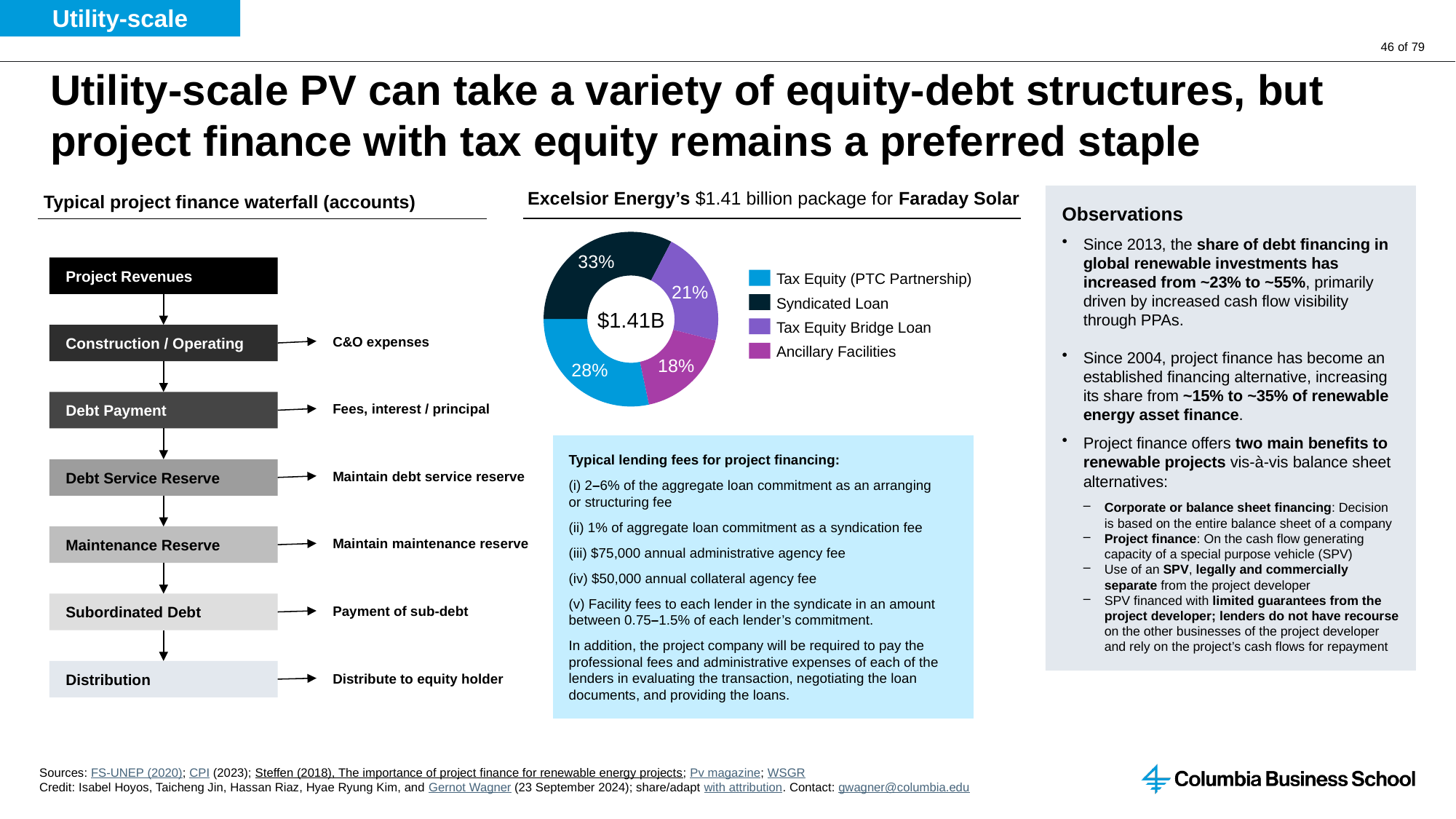
What kind of chart is used to show the Faraday Solar package? Pie chart (donut) What share of the package is Tax Equity (PTC Partnership)? 28% How many slices does the chart have? 4 Which component makes up the smallest share of the package? Ancillary Facilities Which component makes up the largest share of the package? Syndicated Loan How many entries does the chart's legend list? 4 What share of the package is Ancillary Facilities? 18% Which is larger: the Tax Equity (PTC Partnership) share or the Tax Equity Bridge Loan share? Tax Equity (PTC Partnership) What share of the package is the Tax Equity Bridge Loan? 21% What share of the package does the Syndicated Loan represent? 33% How many percentage points larger is the Syndicated Loan share than the Ancillary Facilities share? 15 percentage points What value is printed in the centre of the chart? $1.41B